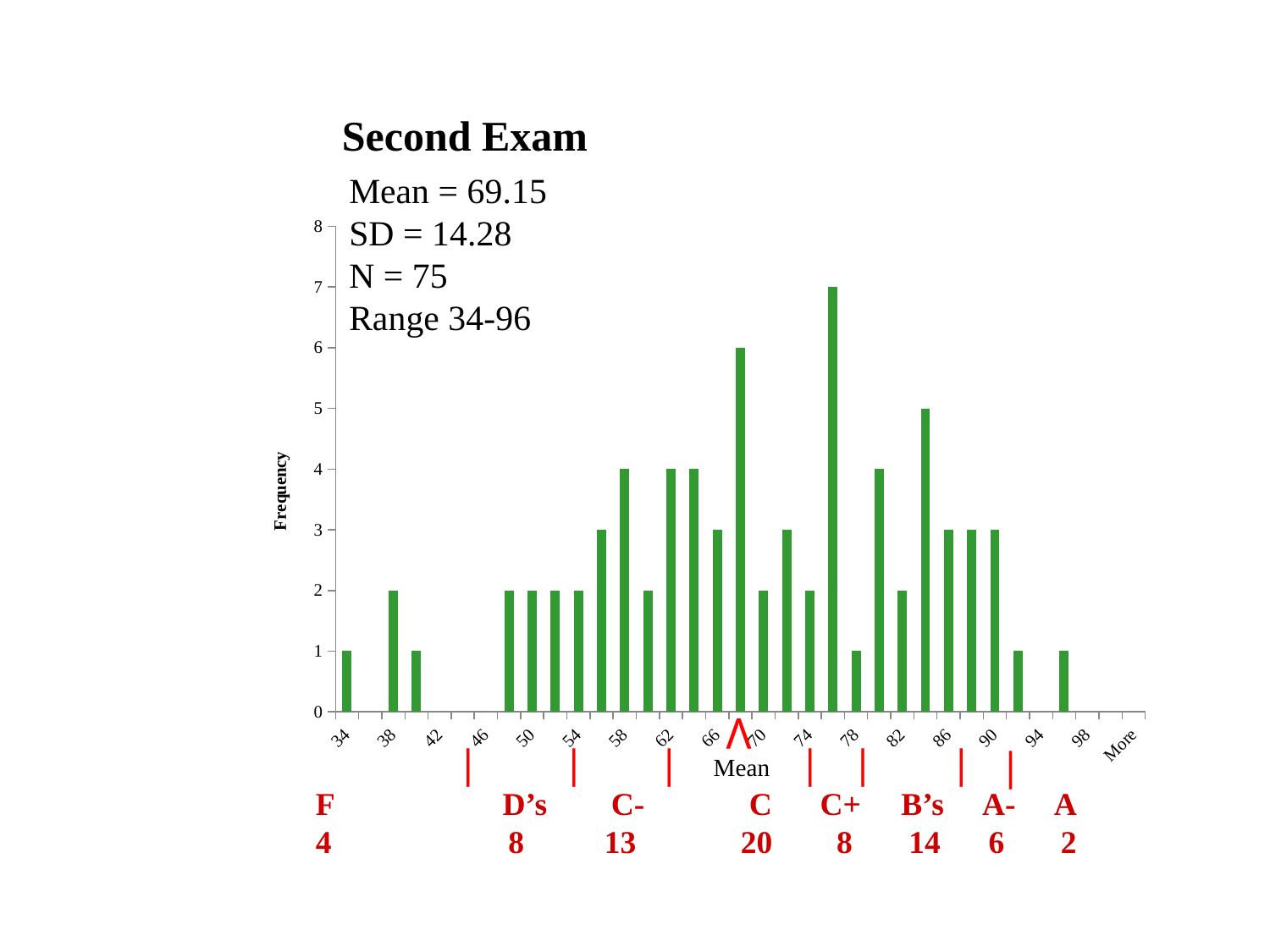
What kind of chart is shown on the slide? bar chart Which score has the larger frequency, 62 or 66? 62 What is the frequency for the score of 34? 1 What is the frequency for the score of 58? 4 What is the title of the chart? Second Exam What mean value is stated on the slide for the Second Exam? 69.15 Is the frequency for the score of 86 greater or less than 4? less According to the red annotations below the chart, how many students received a C? 20 What is the label on the vertical axis of the chart? Frequency What is the highest frequency reached by any bar in the chart? 7 What is the difference between the frequency at 58 and the frequency at 70? 2 What is the frequency for the score of 38? 2